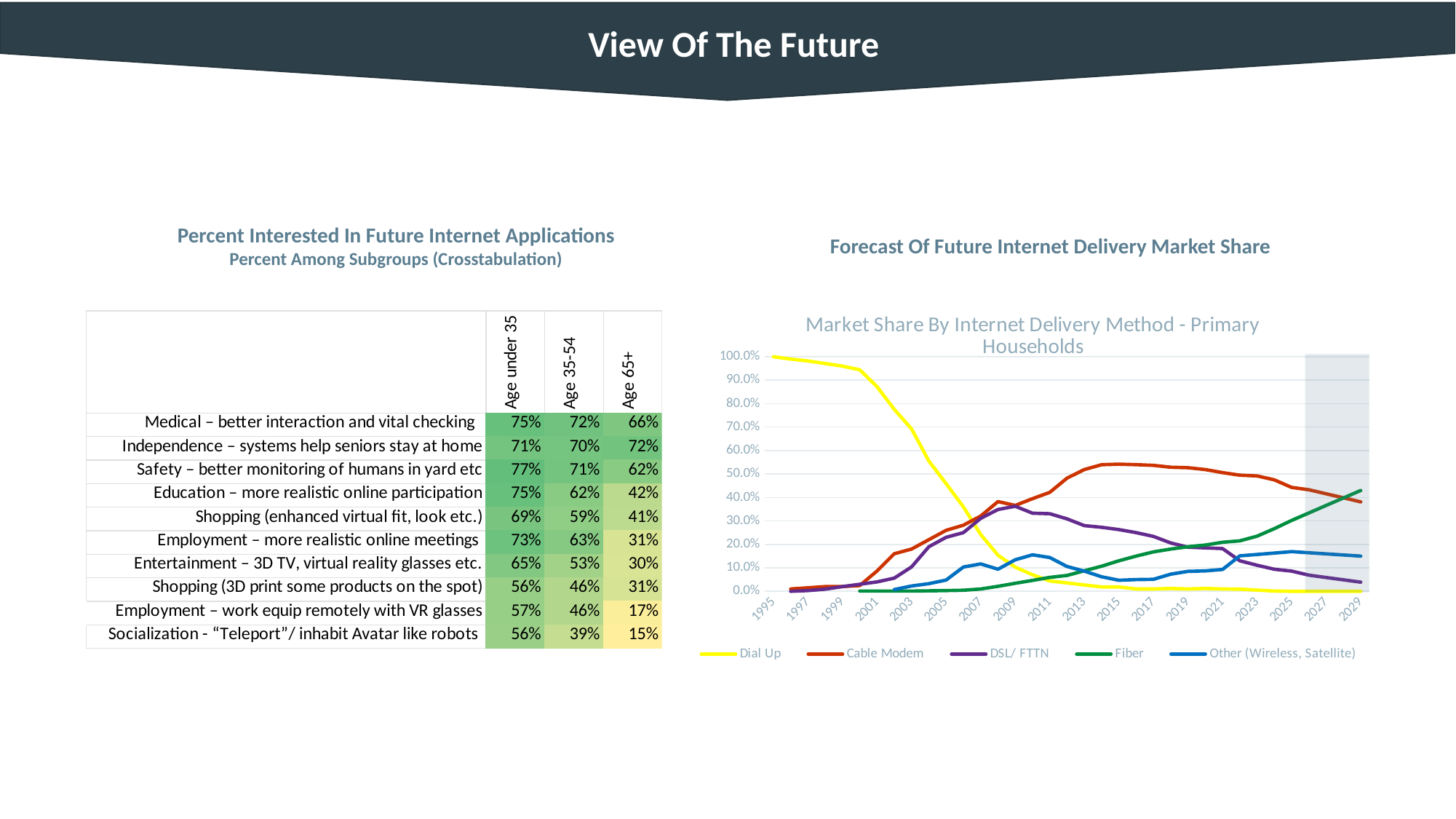
In the market share line chart, is the value for Cable Modem in 2015 greater or less than 50.0%? greater In the market share line chart, is the value for Dial Up in 2011 greater or less than 10.0%? less In the market share line chart, what is the value for Dial Up in 1995? 100.0% How many series does the legend of the market share line chart list? 5 What kind of chart is the 'Market Share By Internet Delivery Method - Primary Households' chart? line chart In the market share line chart, which series has the highest value in 1995? Dial Up In the market share line chart, which is larger in 2021: Cable Modem or Fiber? Cable Modem In the market share line chart, what colour is the Fiber line? green In the market share line chart, which series has the lowest value in 2029? Dial Up In the market share line chart, does the Dial Up series rise or fall from 1995 to 2029? fall In the market share line chart, is the value for DSL/ FTTN in 2029 greater or less than 10.0%? less In the market share line chart, which series has the highest value in 2029? Fiber